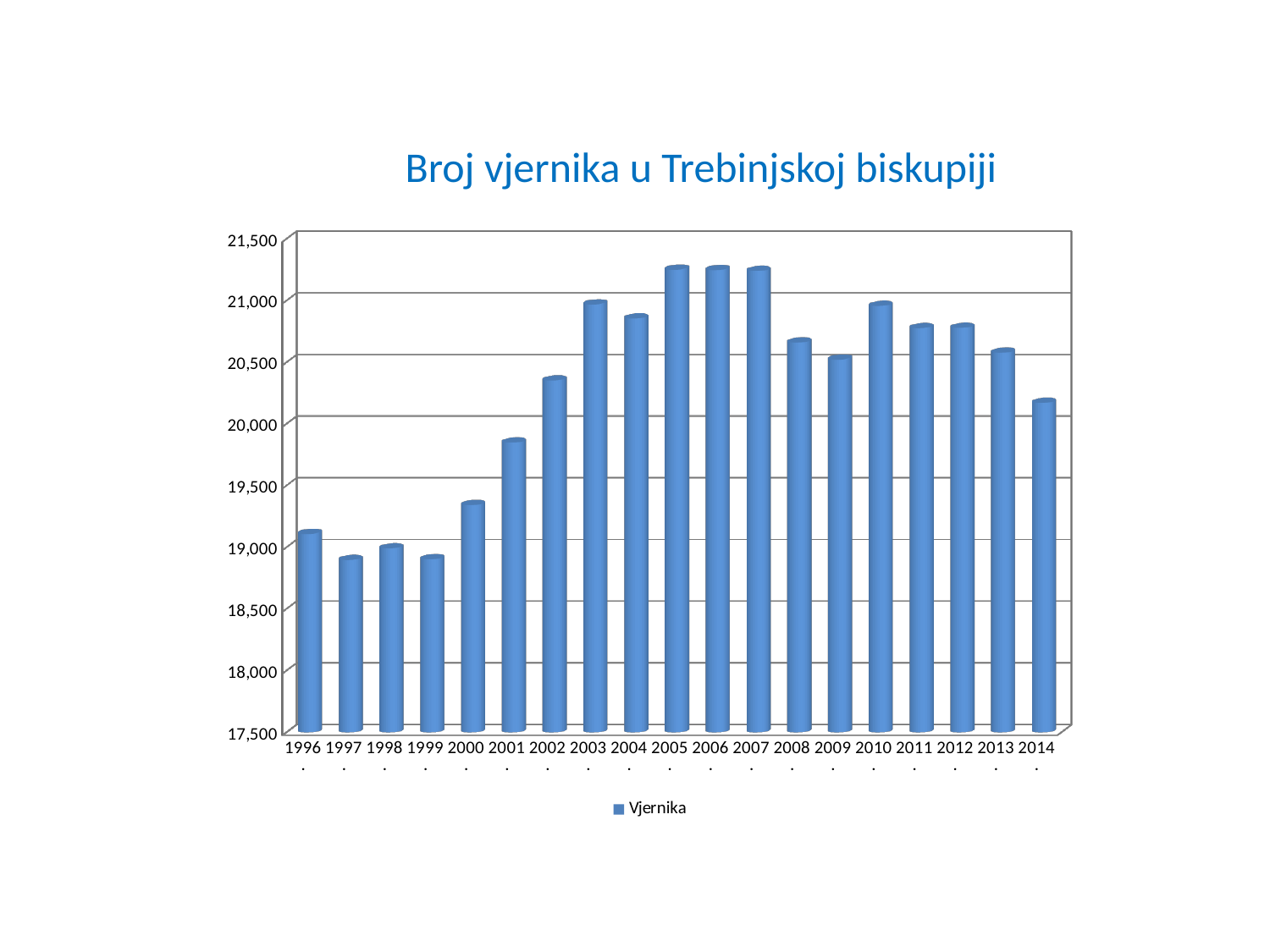
What is the title of the chart? Broj vjernika u Trebinjskoj biskupiji How many series does the legend list? 1 Do the values rise or fall from 2010 to 2014? fall Is the value for 2001 greater or less than 20,000? less How many years are shown on the x axis? 19 What kind of chart is shown on the slide? bar chart Is the value for 2014 greater or less than 20,000? greater Is the value for 1997 greater or less than 19,000? less Which year has the larger value, 2003 or 2004? 2003 Which year has the larger value, 2001 or 2002? 2002